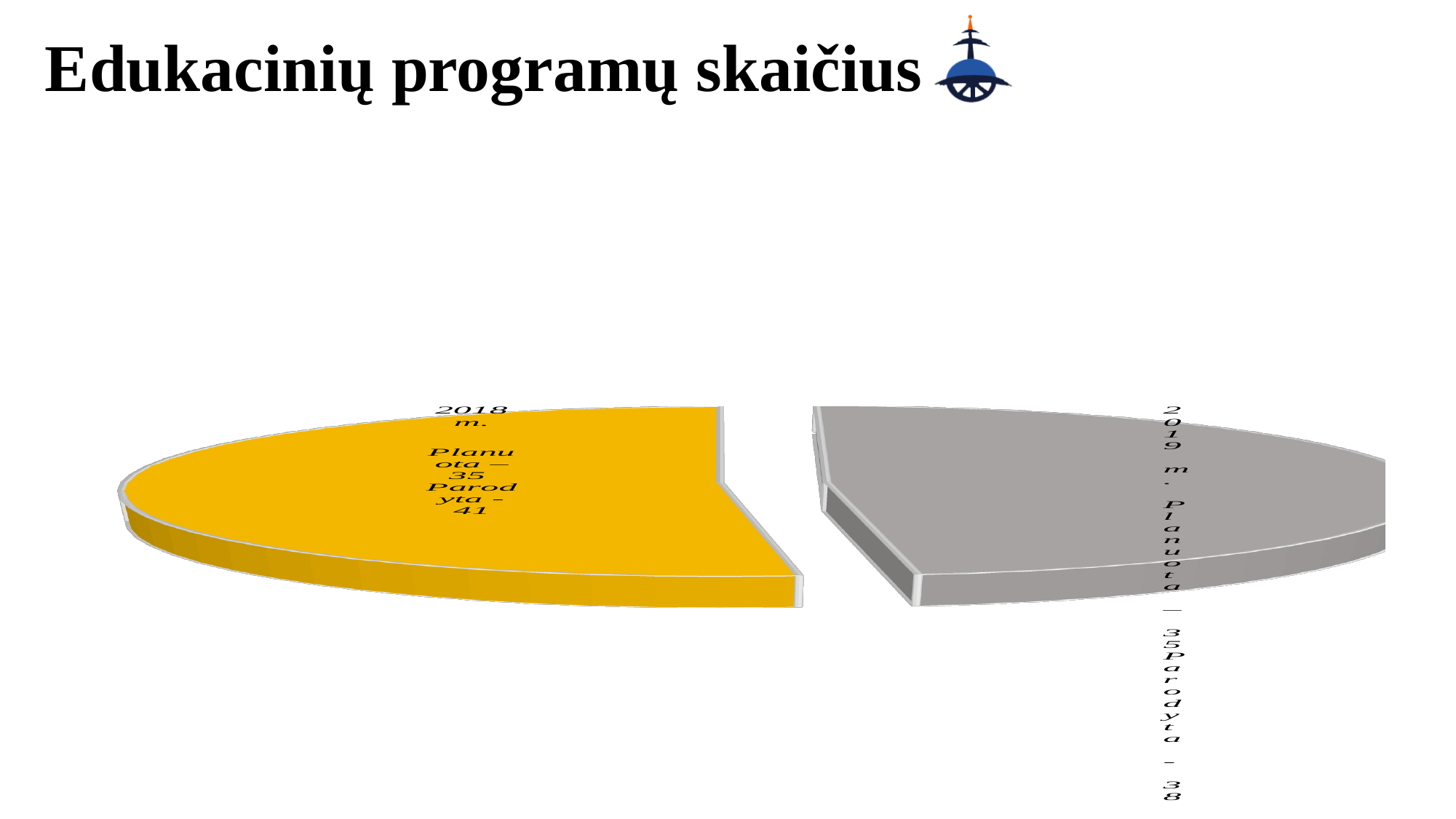
How many programmes were planned (Planuota) for 2018 m.? 35 According to the label, how many programmes were shown (Parodyta) in 2019 m.? 38 What is the difference between the number of programmes shown in 2018 m. and in 2019 m.? 3 How many slices does the pie chart have? 2 In 2018 m., by how much did the number shown (Parodyta) exceed the number planned (Planuota)? 6 What is the title of the slide chart? Edukacinių programų skaičius Which year had more programmes shown (Parodyta), 2018 m. or 2019 m.? 2018 m. In 2019 m., by how much did the number shown (Parodyta) exceed the number planned (Planuota)? 3 What kind of chart is shown on the slide? pie chart According to the label, how many programmes were shown (Parodyta) in 2018 m.? 41 What colour is the slice for 2018 m.? yellow How many programmes were planned (Planuota) for 2019 m.? 35